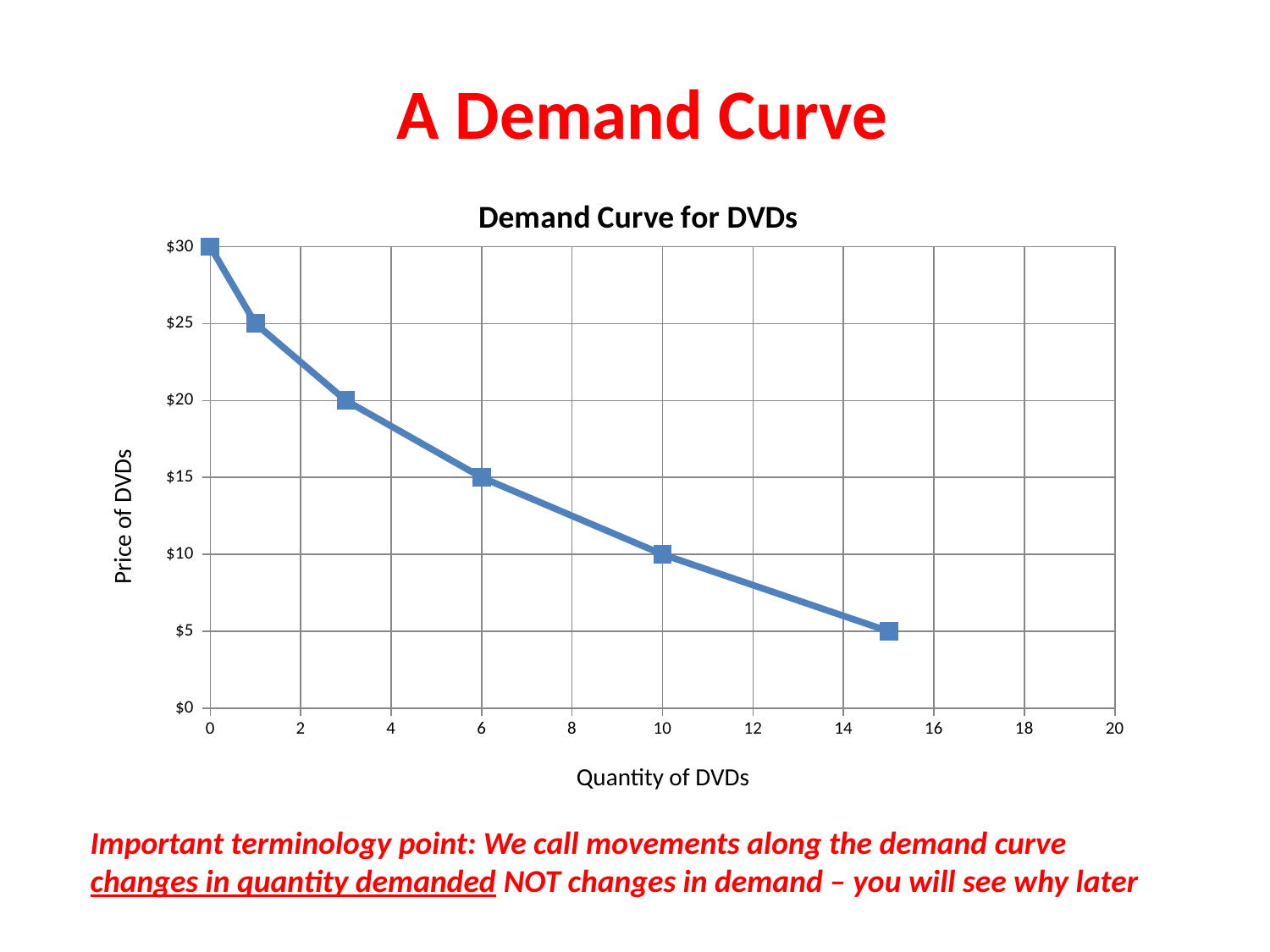
Is the quantity demanded at a price of $5 greater or less than 14? greater What type of chart is shown on the slide? line chart What is the title of the chart? Demand Curve for DVDs What is the label of the vertical axis? Price of DVDs How many data points are plotted on the demand curve? 6 What quantity of DVDs is demanded at a price of $15? 6 What is the price of DVDs when the quantity is 0? $30 What is the price of DVDs when the quantity is 6? $15 What is the difference in price between a quantity of 0 and a quantity of 10? $20 What is the price of DVDs when the quantity is 10? $10 Is the quantity demanded at a price of $20 greater or less than 4? less Does the price rise or fall as the quantity of DVDs increases? fall